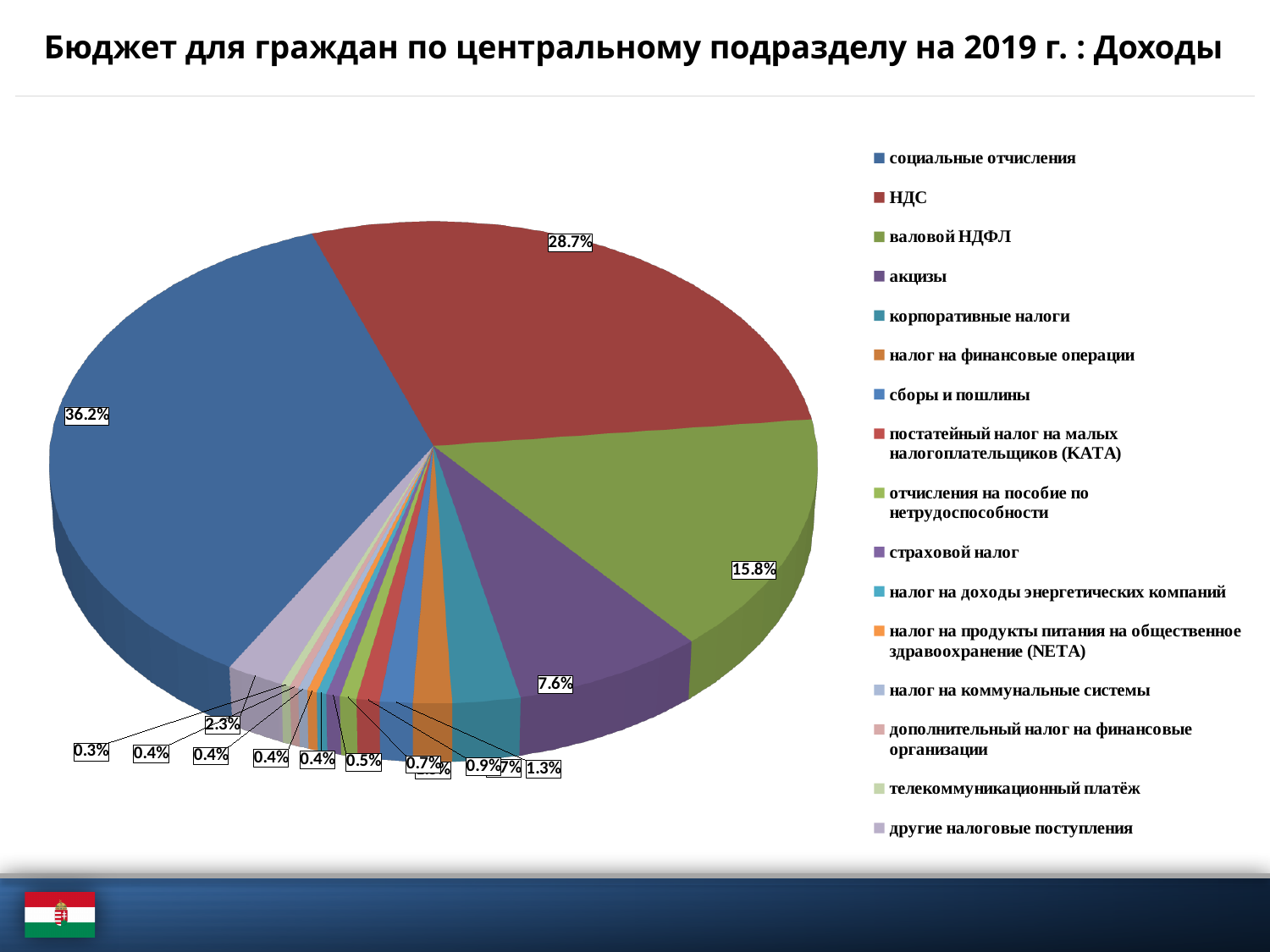
What is the smallest percentage label shown on the chart? 0.3% Which category has the largest share of the pie? социальные отчисления What is the difference in percentage points between социальные отчисления and НДС? 7.5% What percentage is shown for валовой НДФЛ? 15.8% Which has a larger share, валовой НДФЛ or акцизы? валовой НДФЛ What percentage is shown for НДС? 28.7% What is the difference in percentage points between НДС and валовой НДФЛ? 12.9% What percentage is shown for акцизы? 7.6% What is the title of the slide? Бюджет для граждан по центральному подразделу на 2019 г. : Доходы How many categories does the legend list? 16 What share of the pie does социальные отчисления account for? 36.2% What kind of chart is shown on the slide? pie chart